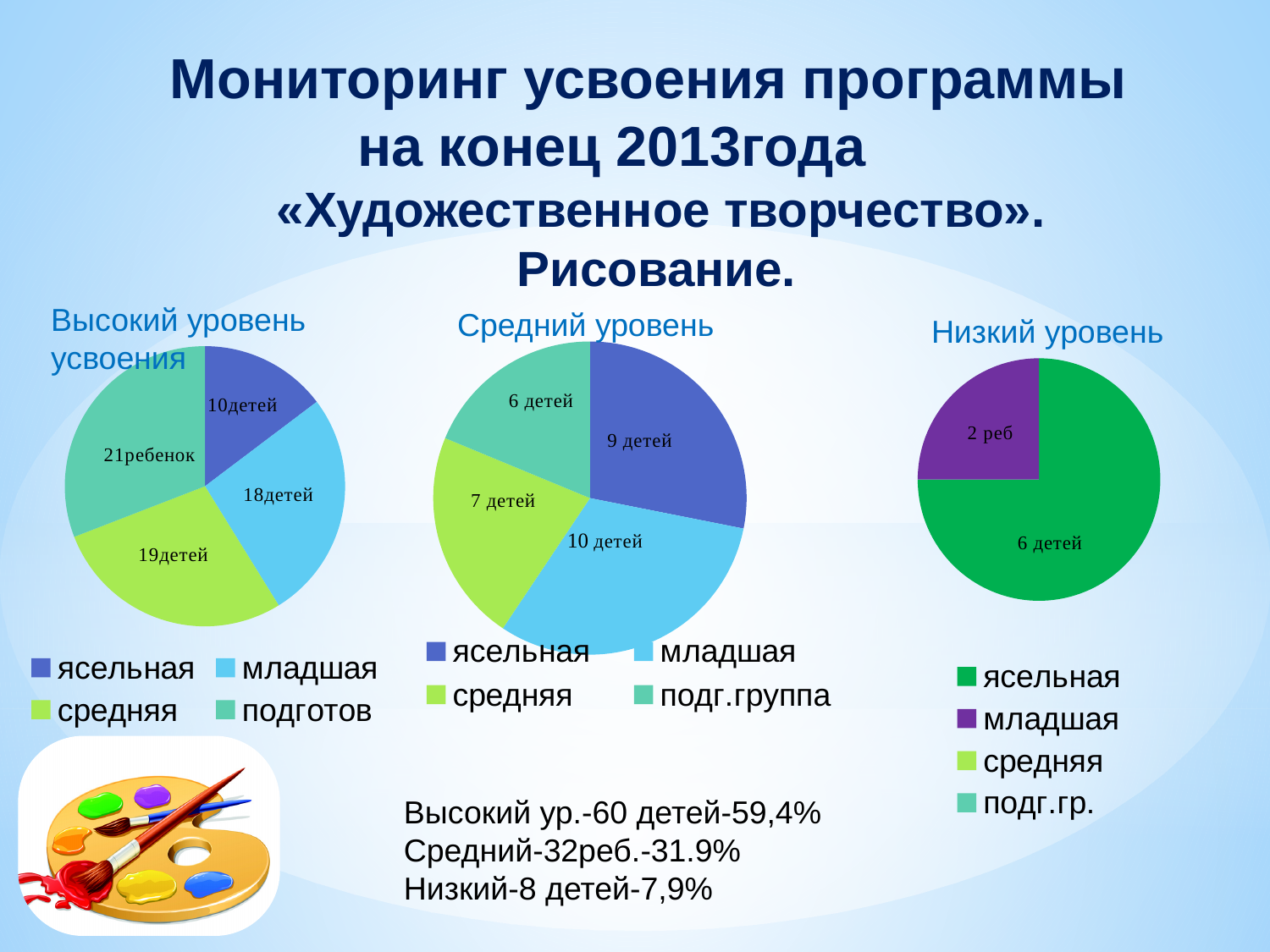
How many entries does the legend of the «Низкий уровень» chart list? 4 On the «Высокий уровень усвоения» pie chart, which group has the largest slice? подготов On the «Средний уровень» pie chart, what is the value for средняя? 7 детей On the «Высокий уровень усвоения» pie chart, which group has the smallest slice? ясельная On the «Высокий уровень усвоения» pie chart, what is the difference between the подготов value and the ясельная value? 11 On the «Низкий уровень» pie chart, what is the value for ясельная? 6 детей On the «Средний уровень» pie chart, which group has the largest slice? младшая What type of chart is the «Высокий уровень усвоения» chart? pie chart On the «Низкий уровень» pie chart, what share of the pie does младшая represent? 25% On the «Средний уровень» pie chart, which is larger: ясельная or подг.группа? ясельная On the «Средний уровень» pie chart, how many slices are there? 4 On the «Высокий уровень усвоения» pie chart, what is the value for младшая? 18детей